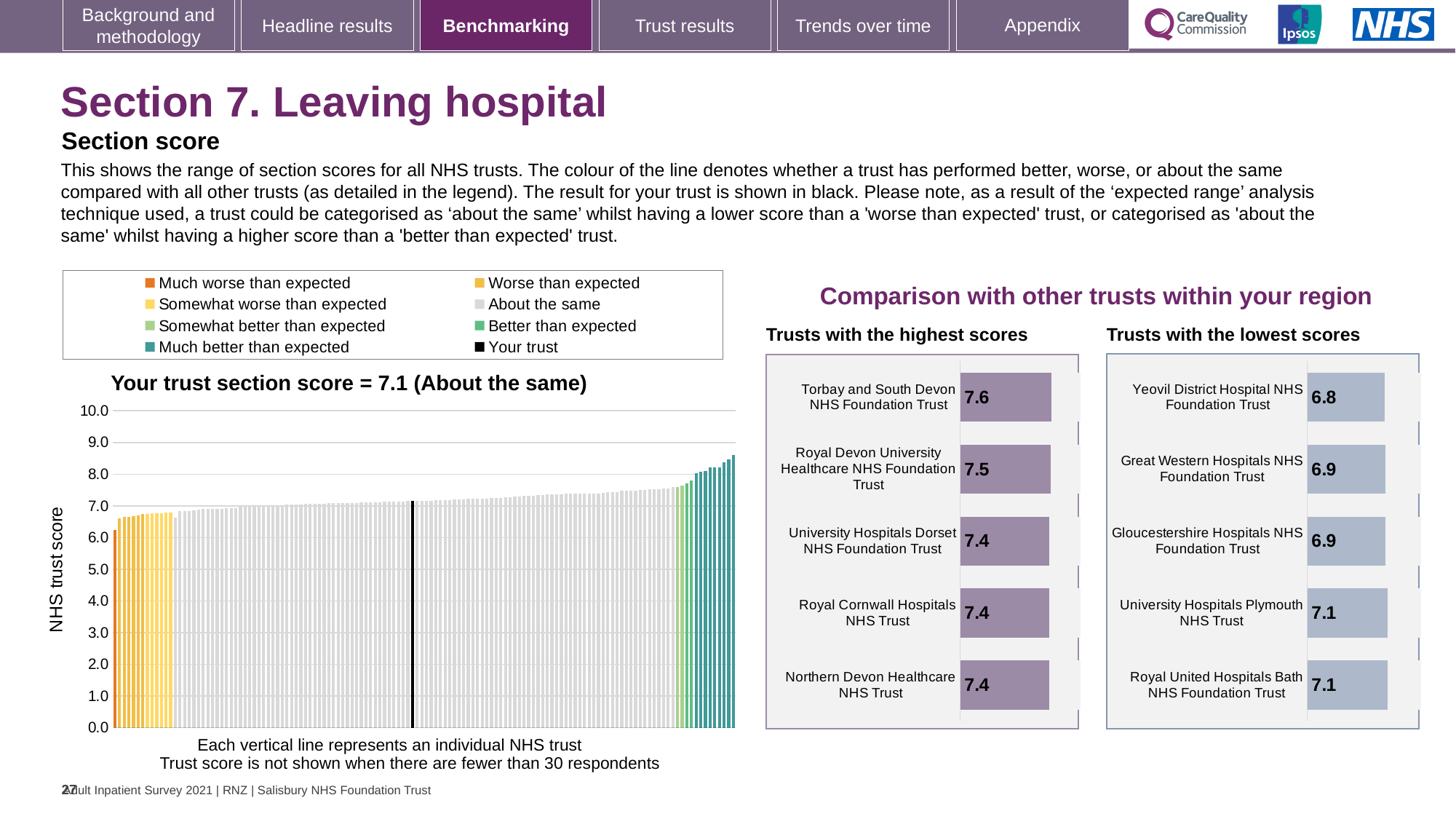
What is the difference between the score for Torbay and South Devon NHS Foundation Trust in the highest scores chart and the score for Yeovil District Hospital NHS Foundation Trust in the lowest scores chart? 0.8 In the 'Trusts with the lowest scores' chart, what is the score for Yeovil District Hospital NHS Foundation Trust? 6.8 In the main section score chart on the left, is the value of the shortest bar greater or less than 7.0? less How many entries does the legend of the main section score chart list? 8 In the main section score chart on the left, what is the section score for your trust? 7.1 In the 'Trusts with the highest scores' chart, what is the score for Torbay and South Devon NHS Foundation Trust? 7.6 In the 'Trusts with the highest scores' chart, which trust has the highest score? Torbay and South Devon NHS Foundation Trust What type of chart is the main section score chart on the left? Bar chart In the 'Trusts with the highest scores' chart, which is larger: the score for Torbay and South Devon NHS Foundation Trust or Royal Devon University Healthcare NHS Foundation Trust? Torbay and South Devon NHS Foundation Trust In the 'Trusts with the lowest scores' chart, which trust has the lowest score? Yeovil District Hospital NHS Foundation Trust In the main section score chart on the left, is the value of the tallest bar greater or less than 8.0? greater How many trusts are listed in the 'Trusts with the lowest scores' chart? 5